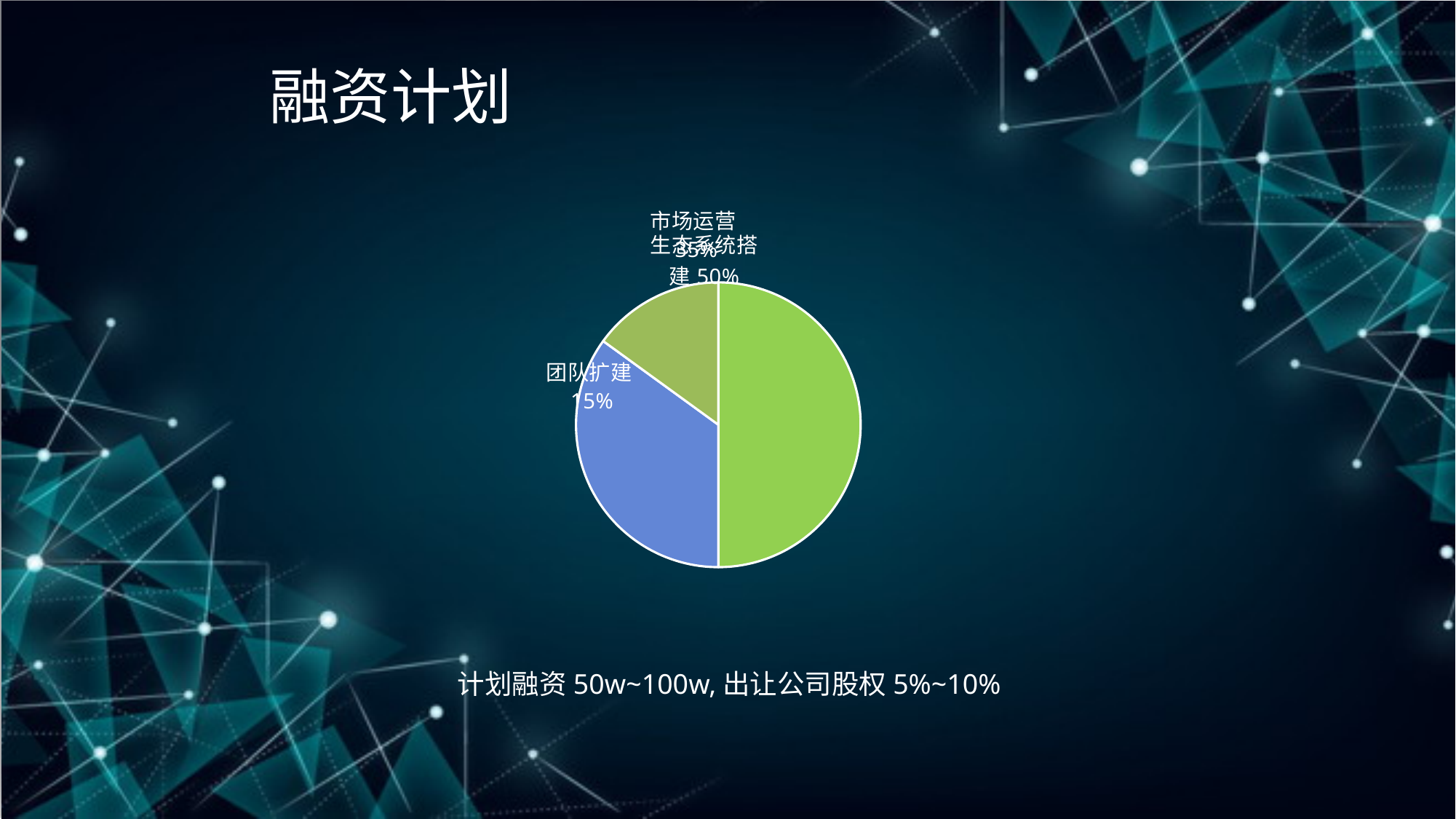
What is the combined share of 市场运营 and 团队扩建? 50% What percentage is shown for 团队扩建? 15% What share of the pie is labelled 生态系统搭建? 50% What is the difference between the shares of 市场运营 and 团队扩建? 20% Which category has the largest share of the pie? 生态系统搭建 Which is larger, the share for 生态系统搭建 or the share for 市场运营? 生态系统搭建 How many slices does the pie chart have? 3 What is the title of the slide containing the pie chart? 融资计划 What kind of chart is shown on the slide? pie chart What percentage is shown for 市场运营? 35% Which category has the smallest share of the pie? 团队扩建 What is the difference between the shares of 生态系统搭建 and 团队扩建? 35%